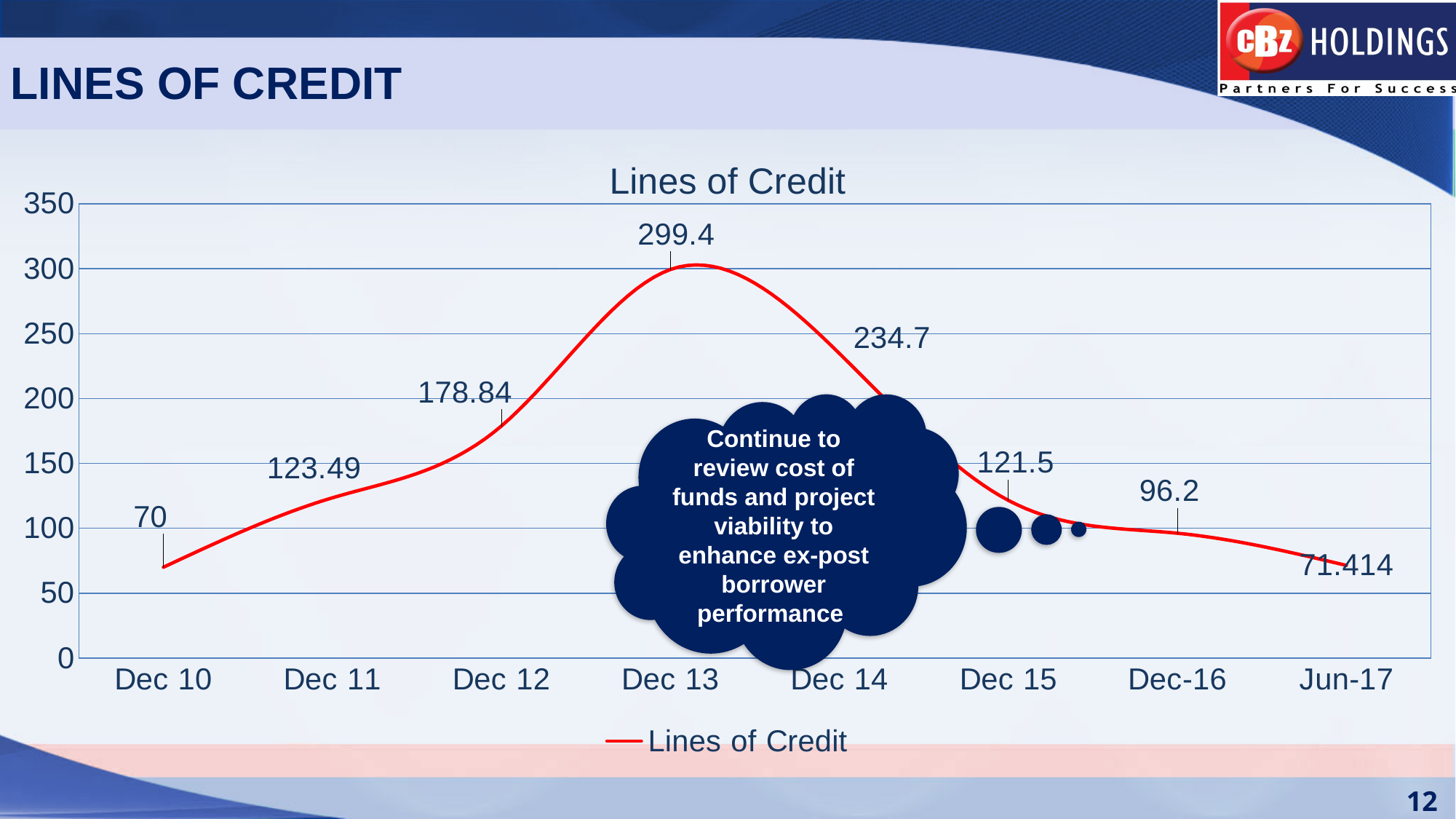
What is the value of Lines of Credit for Dec 10? 70 How many periods are shown on the x axis of the chart? 8 What is the value of Lines of Credit for Dec 13? 299.4 What is the difference between the Lines of Credit values for Dec 13 and Dec 14? 64.7 Which is larger, the Lines of Credit value for Dec 11 or for Dec 15? Dec 11 What is the value of Lines of Credit for Jun-17? 71.414 Is the value for Dec-16 greater or less than 100? less Which period has the highest Lines of Credit value? Dec 13 What is the value of Lines of Credit for Dec 12? 178.84 What kind of chart is shown on the slide? line chart Which period has the lowest Lines of Credit value? Dec 10 Do the Lines of Credit values rise or fall from Dec 13 to Jun-17? fall